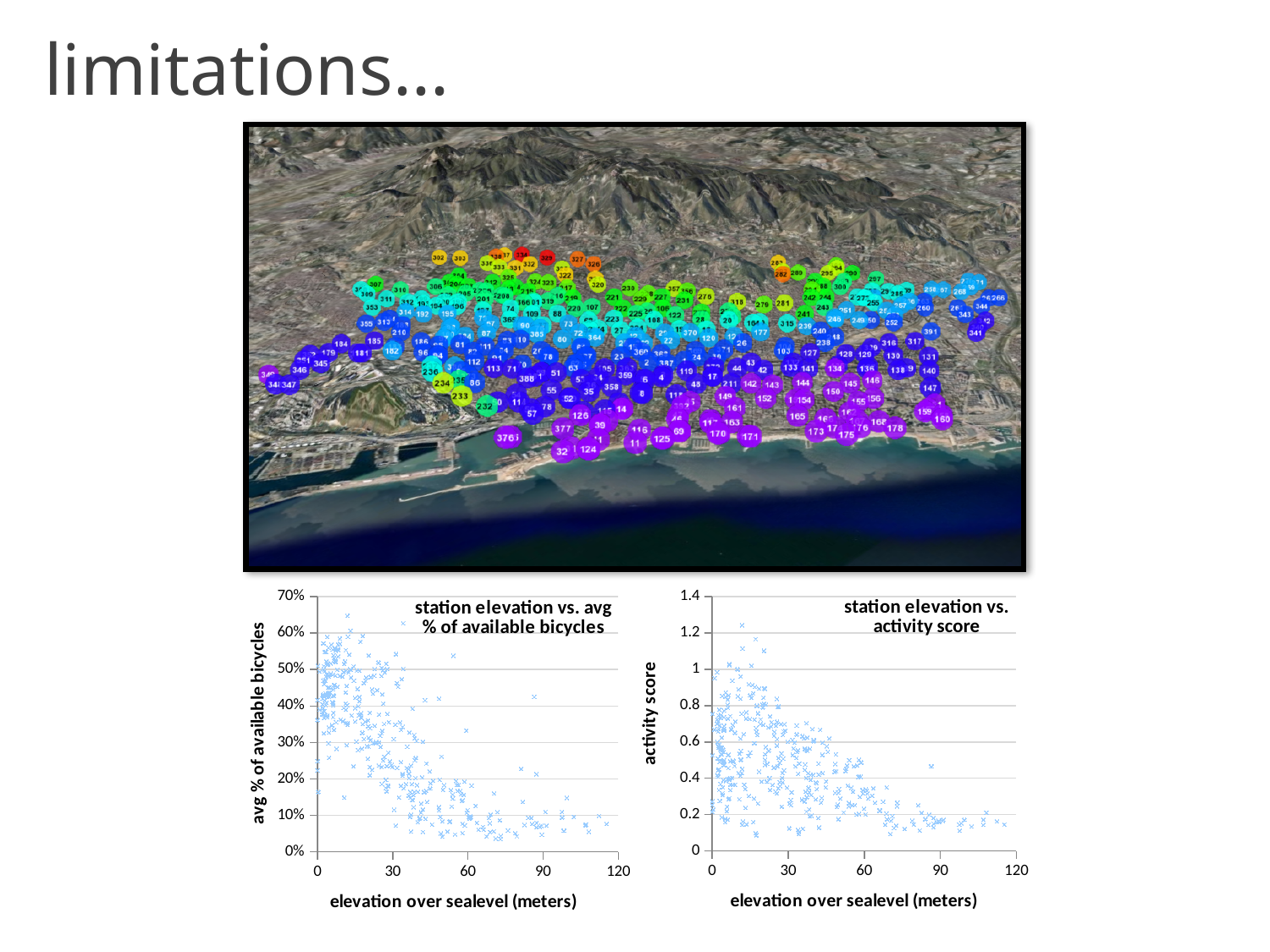
In the 'station elevation vs. avg % of available bicycles' chart, do the values generally rise or fall as elevation increases? fall What is the maximum value shown on the y axis of the 'station elevation vs. activity score' chart? 1.4 In the 'station elevation vs. activity score' chart, are the values for stations above 90 meters elevation greater or less than 0.4? less In the 'station elevation vs. avg % of available bicycles' chart, is the highest plotted value greater or less than 60%? greater In the 'station elevation vs. activity score' chart, do the activity scores generally rise or fall as elevation increases? fall What kind of chart is the 'station elevation vs. activity score' chart? scatter chart In the 'station elevation vs. avg % of available bicycles' chart, are the values for stations above 90 meters elevation greater or less than 20%? less What is the x-axis title of the 'station elevation vs. activity score' chart? elevation over sealevel (meters) What kind of chart is the 'station elevation vs. avg % of available bicycles' chart? scatter chart